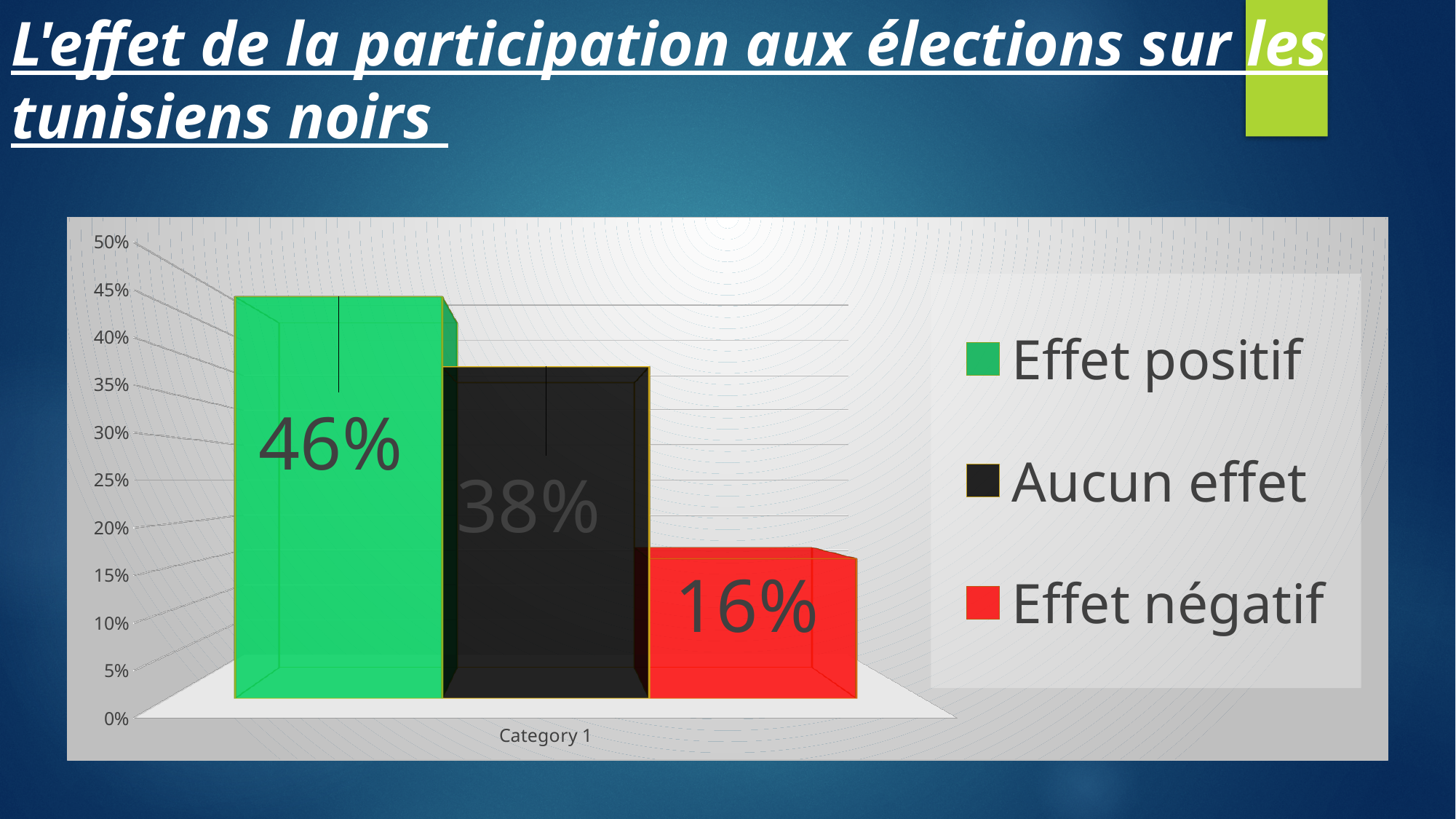
How many series does the legend list? 3 What is the value for Effet positif? 46% What kind of chart is shown on the slide? bar chart Which is larger, Effet positif or Effet négatif? Effet positif What is the value for Effet négatif? 16% Is the value for Aucun effet greater or less than 40%? less What is the value for Aucun effet? 38% What is the difference between Aucun effet and Effet négatif? 22% What colour is the bar for Effet négatif? red What is the difference between Effet positif and Aucun effet? 8% Which series has the lowest value? Effet négatif Which series has the highest value? Effet positif